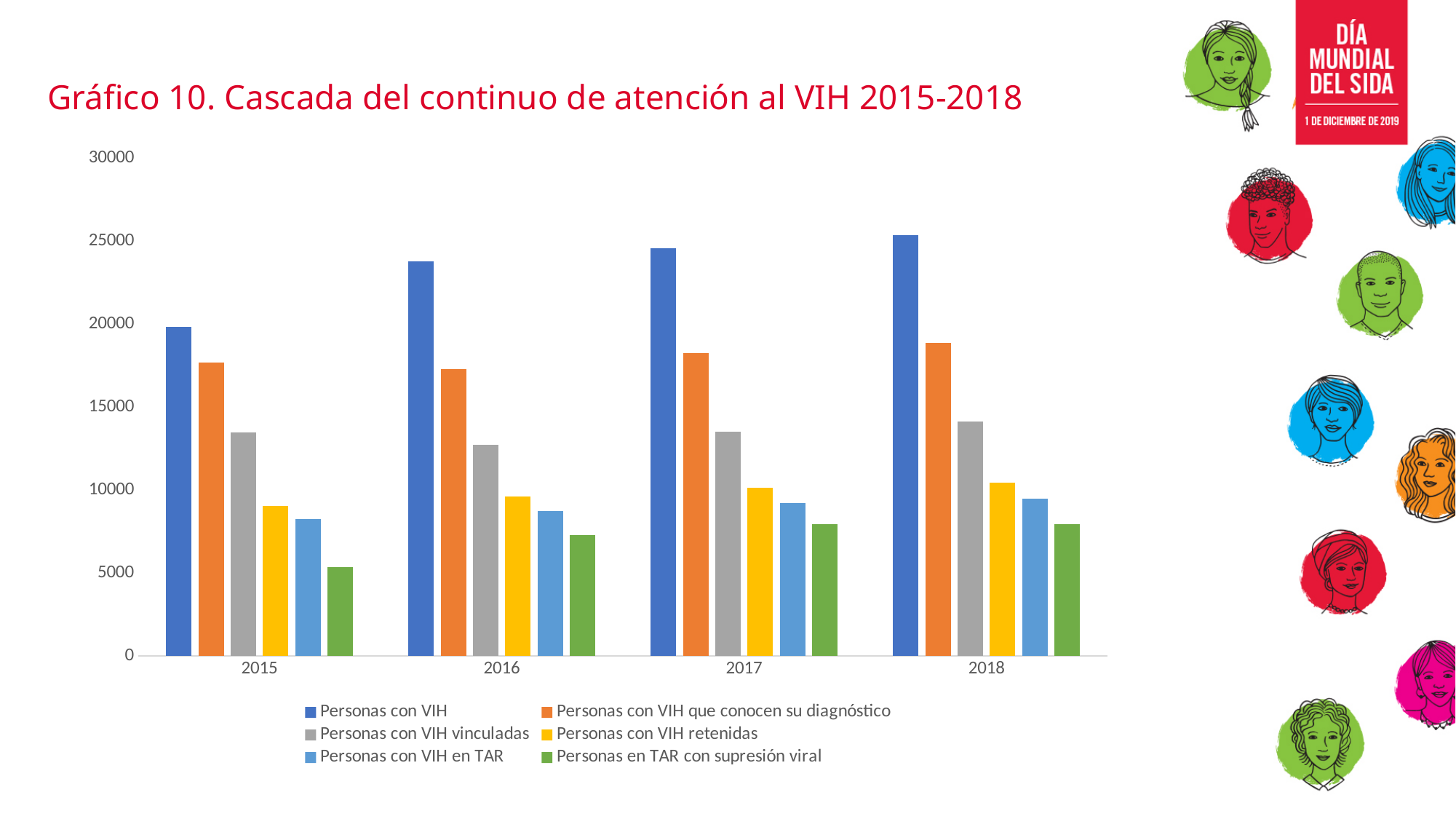
How many series does the legend list? 6 Is the value for Personas con VIH in 2016 greater or less than 20000? greater Is the value for Personas con VIH vinculadas in 2018 greater or less than 15000? less What is the title of the chart? Gráfico 10. Cascada del continuo de atención al VIH 2015-2018 How many years are shown on the x axis? 4 In 2018, which is larger: Personas con VIH retenidas or Personas con VIH en TAR? Personas con VIH retenidas What kind of chart is shown on the slide? bar chart Is the value for Personas en TAR con supresión viral in 2015 greater or less than 10000? less Do the values for Personas con VIH rise or fall from 2015 to 2018? rise In which year is the value for Personas con VIH highest? 2018 In which year is the value for Personas en TAR con supresión viral lowest? 2015 What colour represents Personas con VIH in the chart? blue